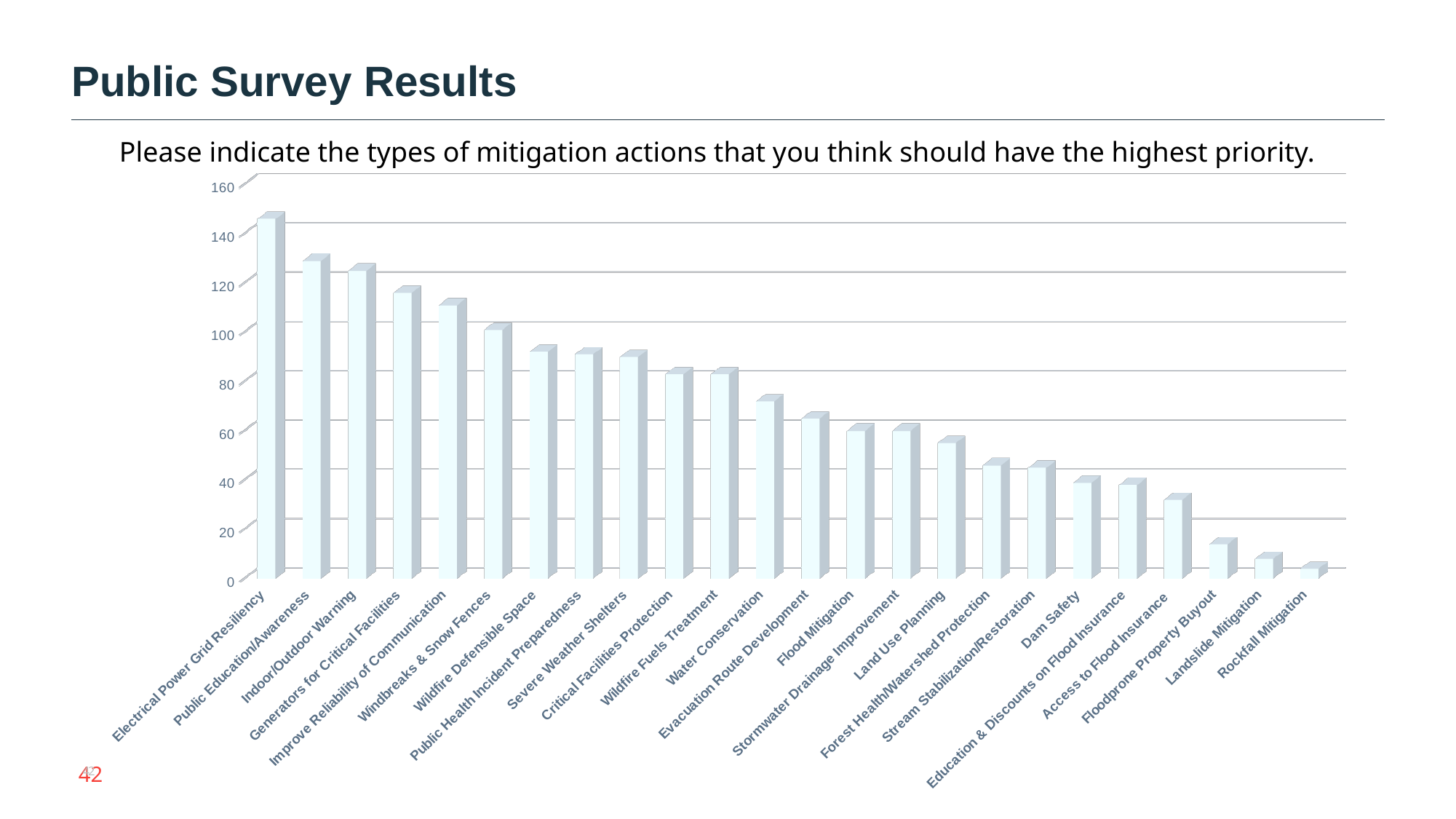
Which mitigation action received the lowest value in the survey results chart? Rockfall Mitigation Is the value for Landslide Mitigation greater or less than 20? less How many mitigation action categories are shown on the x axis of the chart? 24 Is the value for Windbreaks & Snow Fences greater or less than 80? greater Which has a larger value, Public Education/Awareness or Flood Mitigation? Public Education/Awareness Do the values rise or fall moving from left to right along the x axis? fall Which mitigation action received the highest value in the survey results chart? Electrical Power Grid Resiliency Is the value for Electrical Power Grid Resiliency greater or less than 140? greater What is the highest tick value shown on the vertical axis of the chart? 160 What kind of chart is shown on the slide? bar chart